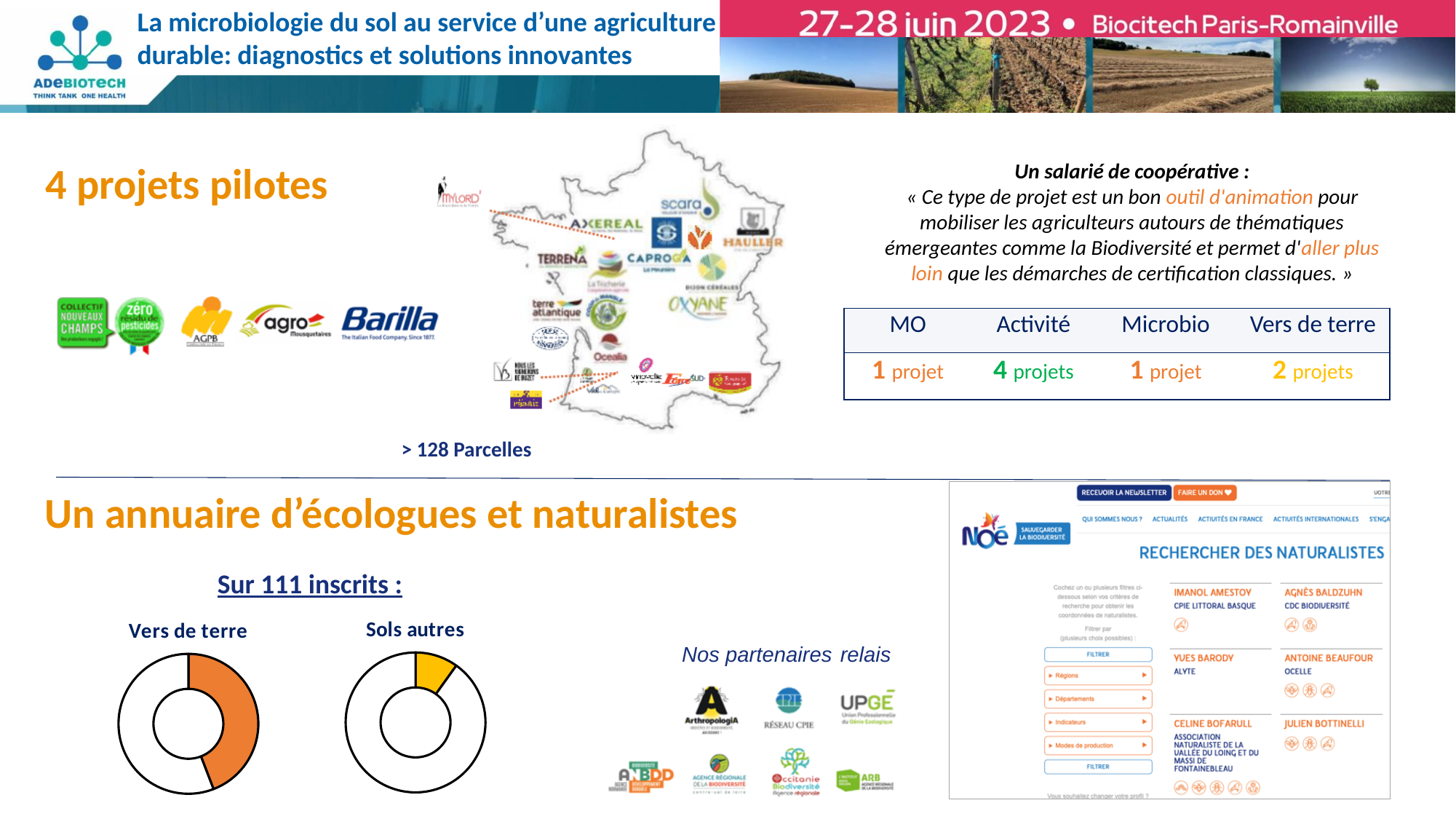
Which doughnut chart has the smaller filled (coloured) share, 'Vers de terre' or 'Sols autres'? Sols autres Is the filled share in the 'Sols autres' doughnut chart greater or less than half of the chart? less What kind of chart is the 'Vers de terre' chart at the bottom left of the slide? doughnut chart What kind of chart is the 'Sols autres' chart at the bottom left of the slide? doughnut chart Is the filled share in the 'Vers de terre' doughnut chart greater or less than half of the chart? less Which doughnut chart has the larger filled (coloured) share, 'Vers de terre' or 'Sols autres'? Vers de terre How many doughnut charts are shown under 'Sur 111 inscrits :'? 2 What colour is the filled slice in the 'Vers de terre' doughnut chart? orange What is the title of the doughnut chart on the far left of the slide? Vers de terre How many slices does each doughnut chart under 'Sur 111 inscrits :' have? 2 What colour is the filled slice in the 'Sols autres' doughnut chart? yellow